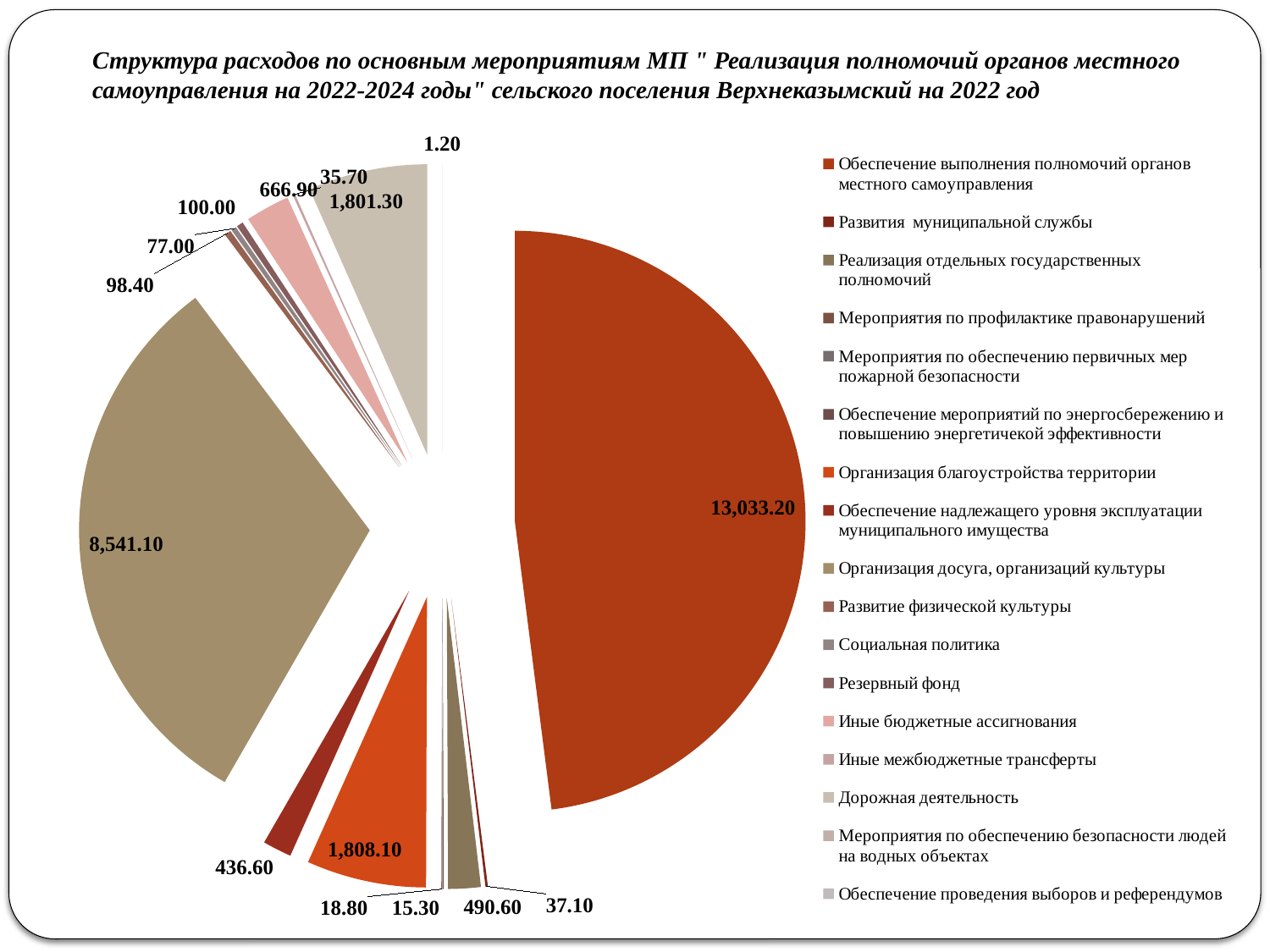
What is the value for Организация благоустройства территории? 1,808.10 What is the value for Дорожная деятельность? 1,801.30 How many entries does the legend list? 17 What is the smallest value labelled on the pie chart? 1.20 Which category has the largest slice of the pie? Обеспечение выполнения полномочий органов местного самоуправления What is the value for Организация досуга, организаций культуры? 8,541.10 Which is larger: the value for Организация досуга, организаций культуры or the value for Организация благоустройства территории? Организация досуга, организаций культуры What kind of chart is shown on the slide? pie chart What is the value for Обеспечение надлежащего уровня эксплуатации муниципального имущества? 436.60 What is the difference between the values for Организация благоустройства территории and Обеспечение надлежащего уровня эксплуатации муниципального имущества? 1,371.50 What is the difference between the values for Обеспечение выполнения полномочий органов местного самоуправления and Организация досуга, организаций культуры? 4,492.10 What is the value for Обеспечение выполнения полномочий органов местного самоуправления? 13,033.20